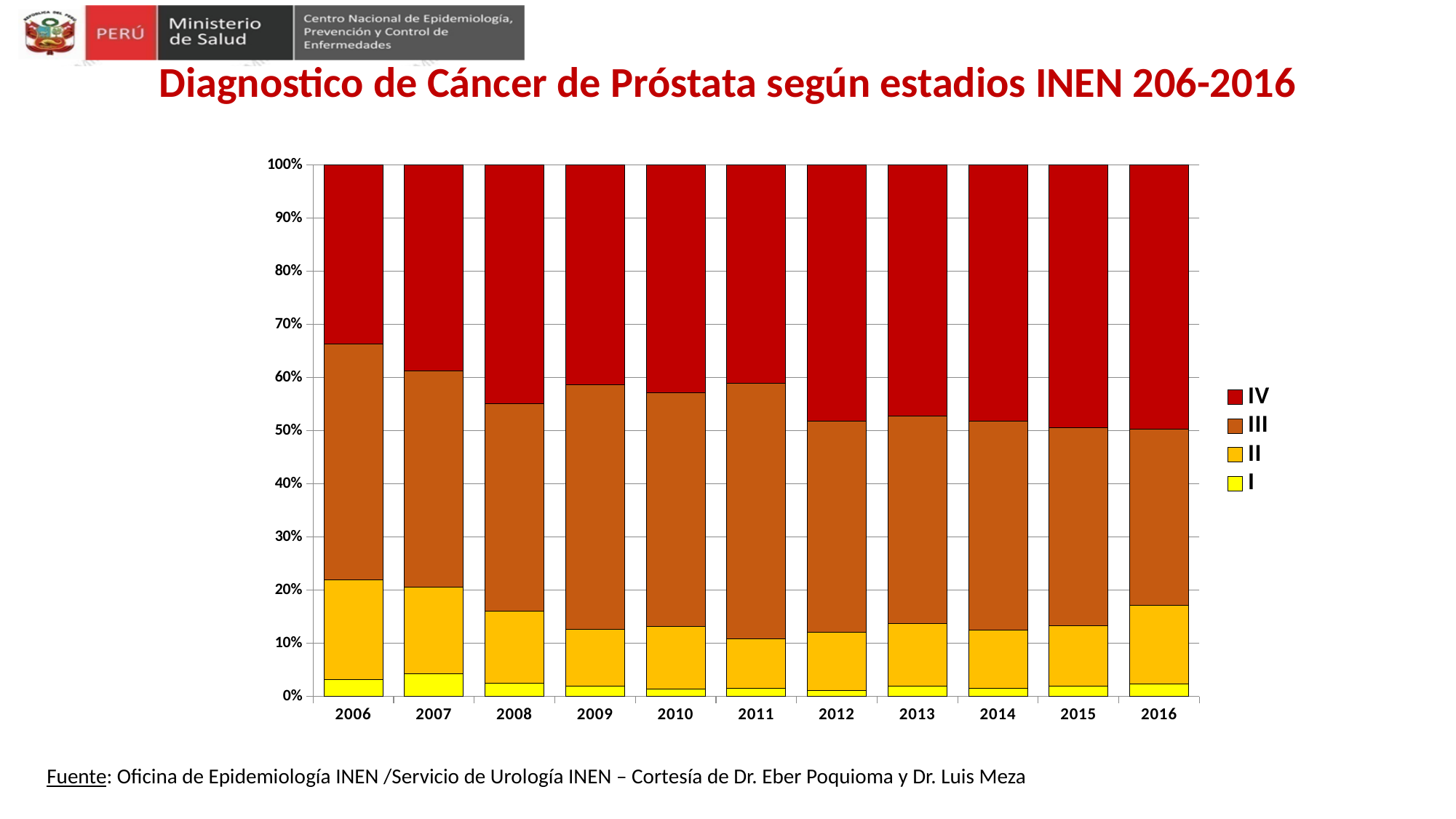
Which year has the smallest share of stage IV? 2006 Is the share of stage I in 2007 greater or less than 10%? less Is the combined share of stages I, II and III in 2006 greater or less than 60%? greater How many series does the chart legend list? 4 Is the share of stage IV in 2016 greater or less than 40%? greater What is the title of the chart on the slide? Diagnostico de Cáncer de Próstata según estadios INEN 206-2016 Which series is shown in red in the chart? IV How many years are shown along the x axis of the chart? 11 Is the share of stage IV larger in 2006 or in 2016? 2016 Which year has the largest share of stage II? 2006 What kind of chart is shown on the slide? Stacked bar chart Does the share of stage IV generally rise or fall from 2006 to 2016? rise